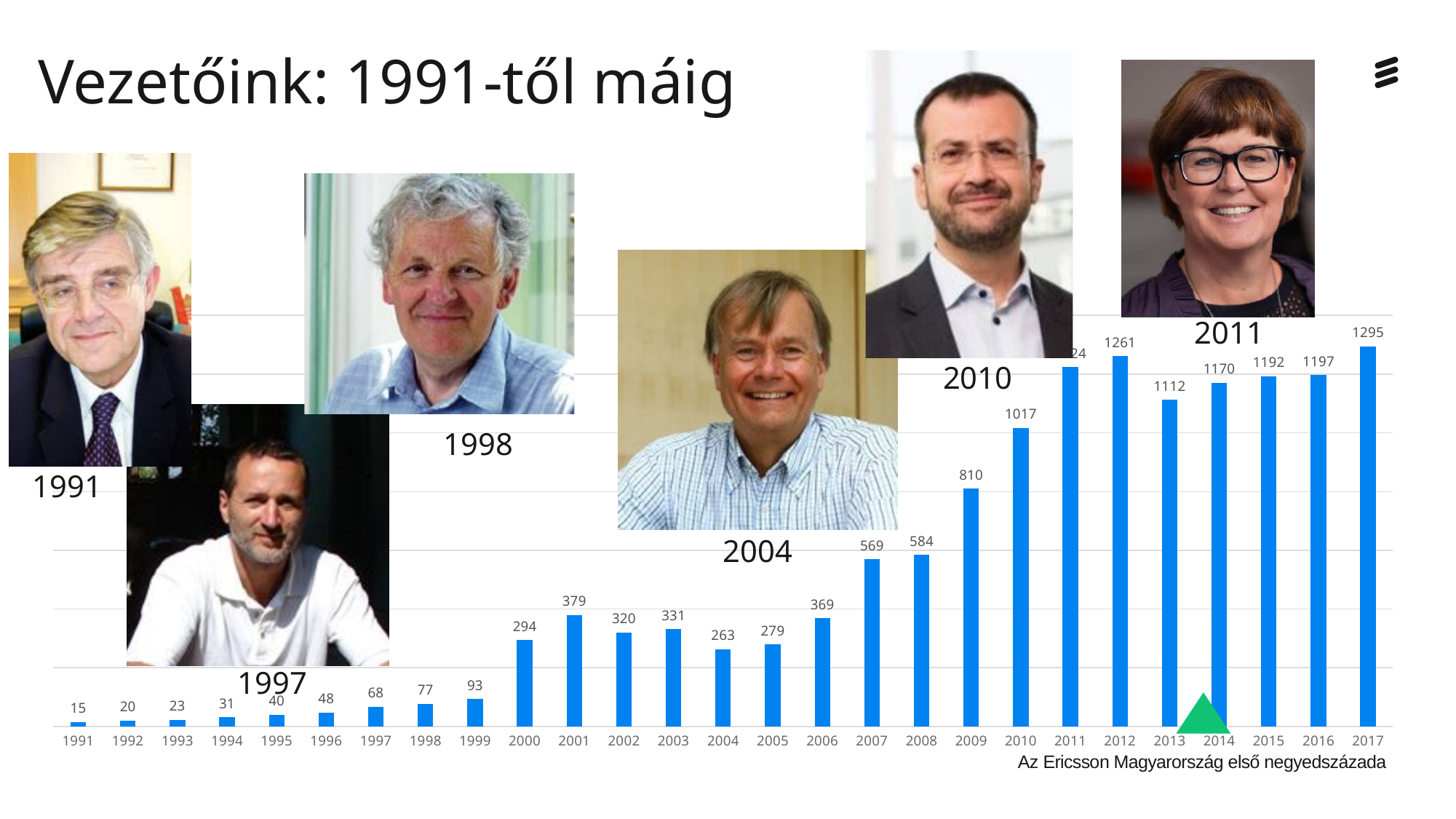
Which year has the lowest value? 1991 What is the value for 2009? 810 What is the value for 1991? 15 Which is larger, the value for 2001 or the value for 2003? 2001 What type of chart is shown on the slide? bar chart What is the difference between the values for 2010 and 2009? 207 How many years are shown on the x axis? 27 What is the difference between the values for 2012 and 2013? 149 What is the value for 2017? 1295 Do the values generally rise or fall from 1991 to 2017? rise What is the value for 2000? 294 Which year has the highest value? 2017